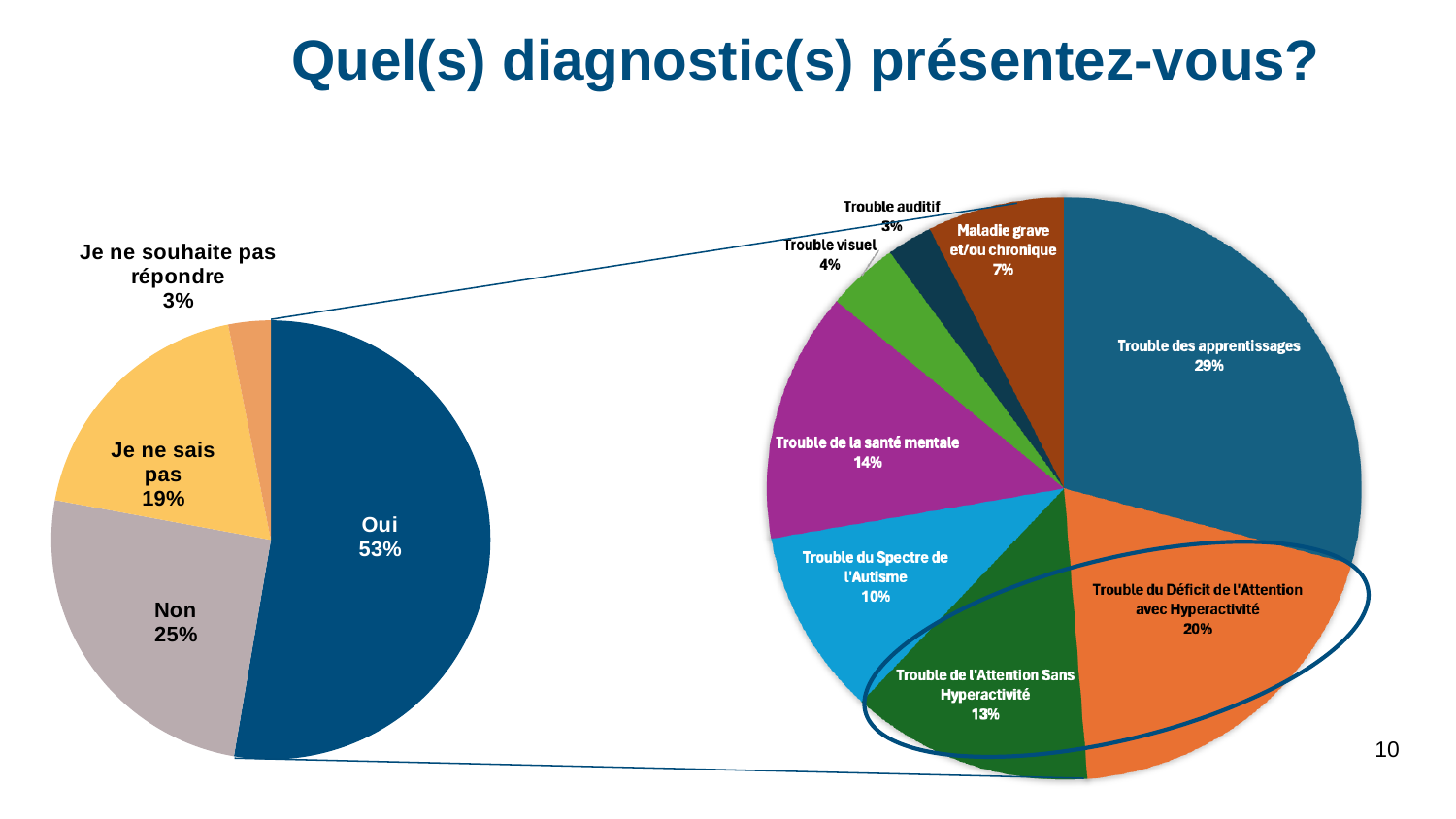
In the right pie chart, which category has the largest share? Trouble des apprentissages What type of chart is used on the left side of the slide? Pie chart In the left pie chart, what is the difference in percentage points between "Oui" and "Non"? 28 In the right pie chart, which category has the smallest share? Trouble auditif In the right pie chart, what is the share for "Trouble du Déficit de l'Attention avec Hyperactivité"? 20% How many slices does the left pie chart have? 4 In the left pie chart, what percentage of respondents answered "Oui"? 53% In the right pie chart, what is the share for "Trouble des apprentissages"? 29% How many slices does the right pie chart have? 8 In the right pie chart, which is larger: "Trouble de la santé mentale" or "Trouble du Spectre de l'Autisme"? Trouble de la santé mentale In the left pie chart, which category has the smallest share? Je ne souhaite pas répondre In the left pie chart, what percentage answered "Je ne sais pas"? 19%